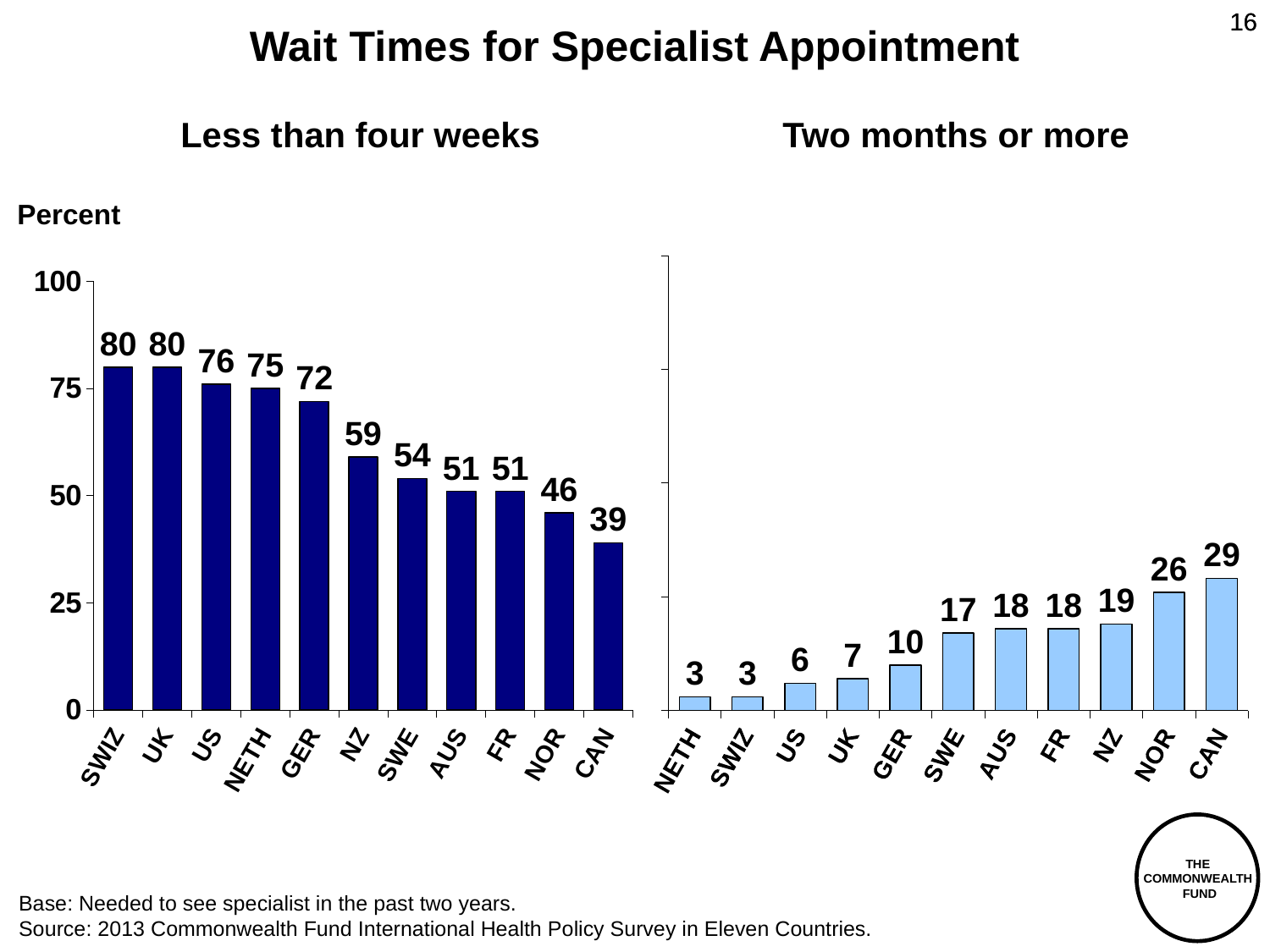
How many countries are shown in the 'Less than four weeks' chart? 11 In the 'Two months or more' chart, which country has the highest value? CAN In the 'Two months or more' chart, what is the value for NOR? 26 In the 'Two months or more' chart, is the value for NZ greater or less than 25? less In the 'Two months or more' chart, do the values rise or fall from left to right? rise In the 'Two months or more' chart, what is the difference between the values for CAN and NETH? 26 What is the title of the slide? Wait Times for Specialist Appointment In the 'Less than four weeks' chart, which country has the lowest value? CAN In the 'Less than four weeks' chart, what is the value for GER? 72 In the 'Less than four weeks' chart, which is larger, the value for SWE or the value for NOR? SWE What kind of chart is the 'Two months or more' chart? bar chart In the 'Less than four weeks' chart, what is the difference between the values for US and NZ? 17